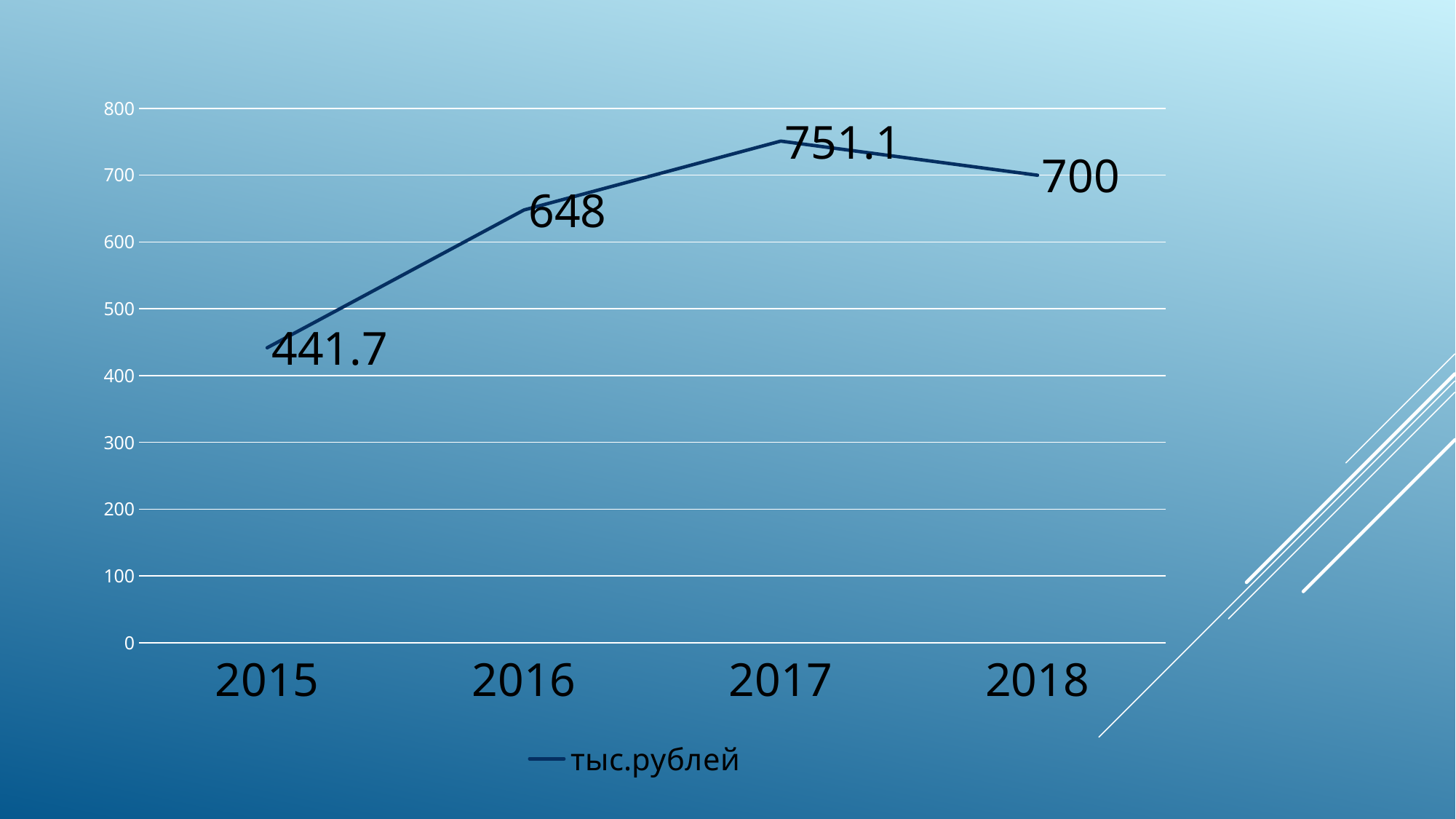
What is the value for 2017? 751.1 Which is larger, the value for 2016 or the value for 2018? 2018 Which year has the lowest value? 2015 Which year has the highest value? 2017 What kind of chart is shown on the slide? line chart What is the name of the series shown in the legend? тыс.рублей What is the difference between the values for 2017 and 2018? 51.1 What is the value for 2018? 700 How many years are plotted on the chart? 4 What is the difference between the values for 2016 and 2015? 206.3 What is the value for 2016? 648 What is the value for 2015? 441.7